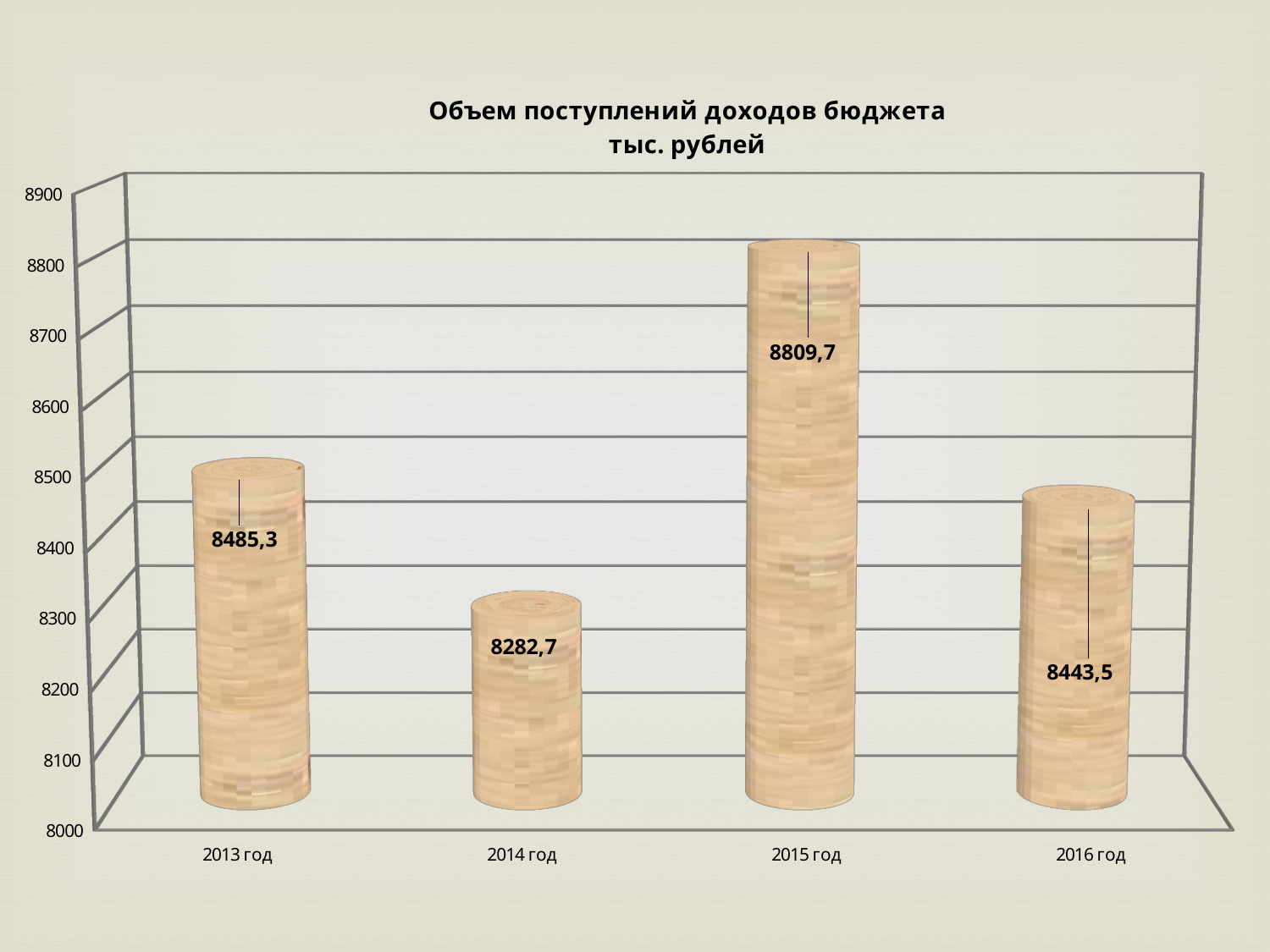
Which year has the lowest value? 2014 год What is the value for 2015 год? 8809,7 What is the difference between the values for 2013 год and 2016 год? 41,8 Which year has the highest value? 2015 год What is the value for 2016 год? 8443,5 Which is larger, the value for 2013 год or the value for 2016 год? 2013 год What is the value for 2013 год? 8485,3 What kind of chart is this? bar chart What is the difference between the values for 2015 год and 2014 год? 527 How many years are shown on the chart? 4 What is the title of the chart? Объем поступлений доходов бюджета тыс. рублей What is the value for 2014 год? 8282,7